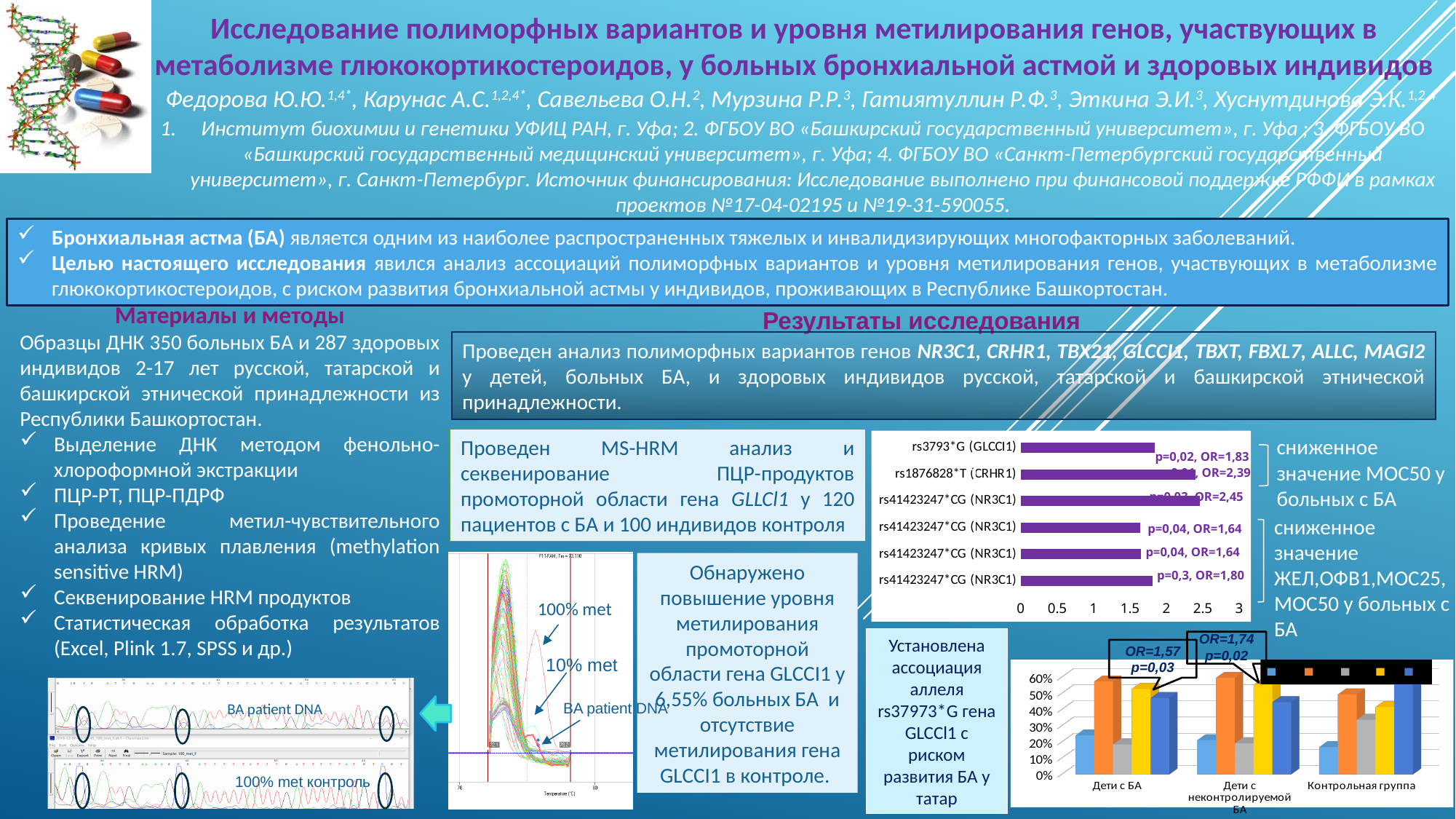
In the horizontal bar chart of odds ratios (top right), is the bar for rs3793*G (GLCCI1) greater or less than 2? less In the horizontal bar chart of odds ratios (top right), what is the OR value for rs1876828*T (CRHR1)? 2,39 What kind of chart is the odds-ratio chart in the top right of the slide? bar chart In the horizontal bar chart of odds ratios (top right), what is the OR value for rs3793*G (GLCCI1)? 1,83 In the 3D bar chart at the bottom right, is the orange bar for 'Дети с БА' greater or less than 50%? greater In the horizontal bar chart of odds ratios (top right), what is the highest OR value shown? 2,45 In the horizontal bar chart of odds ratios (top right), which has the larger OR: rs1876828*T (CRHR1) or rs3793*G (GLCCI1)? rs1876828*T (CRHR1) In the 3D bar chart at the bottom right, how many groups are shown on the x axis? 3 In the horizontal bar chart of odds ratios (top right), how many bars are plotted? 6 In the horizontal bar chart of odds ratios (top right), what is the difference between the OR for rs1876828*T (CRHR1) and the OR for rs3793*G (GLCCI1)? 0,56 In the 3D bar chart at the bottom right, how many series does the legend list? 5 In the horizontal bar chart of odds ratios (top right), what p-value is shown for rs3793*G (GLCCI1)? p=0,02